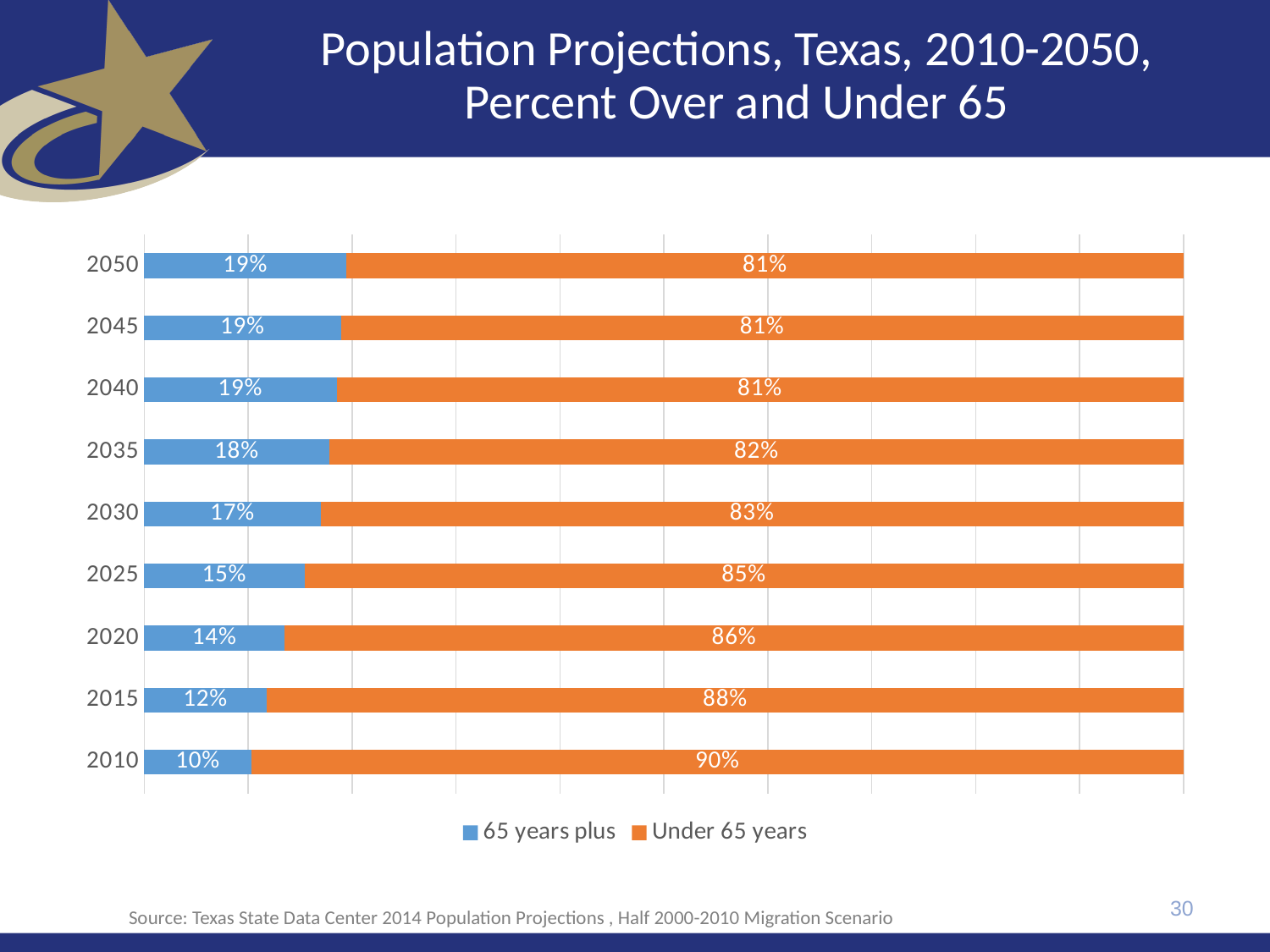
By how many percentage points does the 65 years plus share in 2050 exceed that in 2010? 9 percentage points What kind of chart is shown on the slide? Stacked bar chart Which year has the lowest 65 years plus percentage? 2010 What percentage of the Texas population is projected to be 65 years plus in 2030? 17% How many years are shown on the chart? 9 Is the 65 years plus share larger in 2025 or in 2020? 2025 Which year has the highest under 65 years percentage? 2010 Does the 65 years plus percentage rise or fall from 2010 to 2050? Rise Which colour represents the under 65 years series? Orange What is the 65 years plus share shown for 2010? 10% What percentage of the Texas population is projected to be under 65 years in 2015? 88% How many series does the legend list? 2